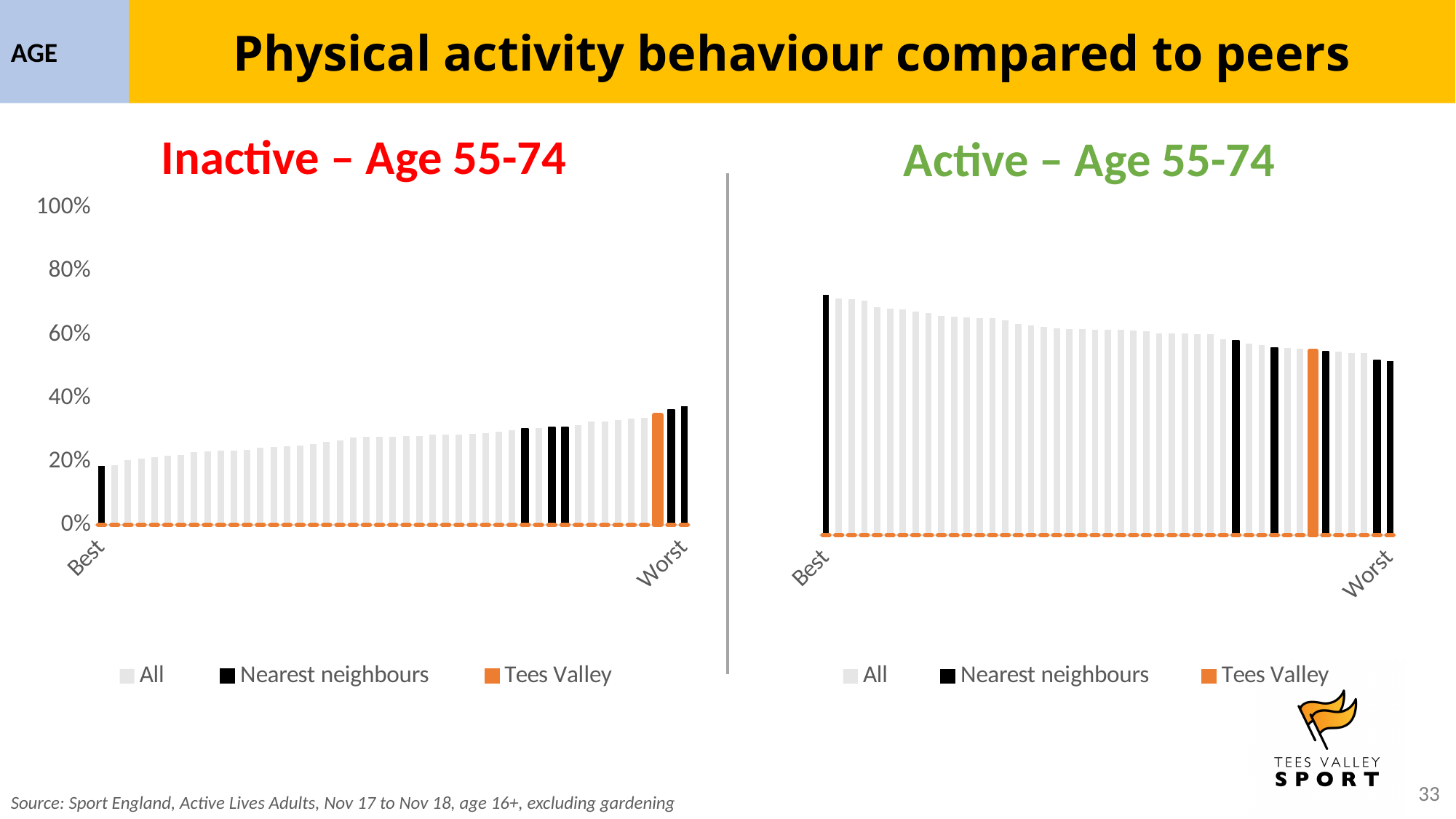
What kind of chart is the Inactive – Age 55-74 chart? Bar chart On the Inactive – Age 55-74 chart, is the Tees Valley value greater or less than 40%? less What are the three legend entries on the Inactive – Age 55-74 chart? All, Nearest neighbours, Tees Valley What are the two labels shown on the x axis of the Active – Age 55-74 chart? Best and Worst How many series does the legend of the Active – Age 55-74 chart list? 3 On the Inactive – Age 55-74 chart, is the value of the Worst bar greater or less than 60%? less On the Inactive – Age 55-74 chart, which is larger: the Tees Valley bar or the Best bar? Tees Valley On the Active – Age 55-74 chart, which is larger: the Best bar or the Tees Valley bar? Best On the Active – Age 55-74 chart, do the bars rise or fall from Best to Worst? Fall On the Inactive – Age 55-74 chart, is the Tees Valley value greater or less than 20%? greater On the Inactive – Age 55-74 chart, do the bars rise or fall from Best to Worst? Rise On the Active – Age 55-74 chart, which colour represents Tees Valley? Orange